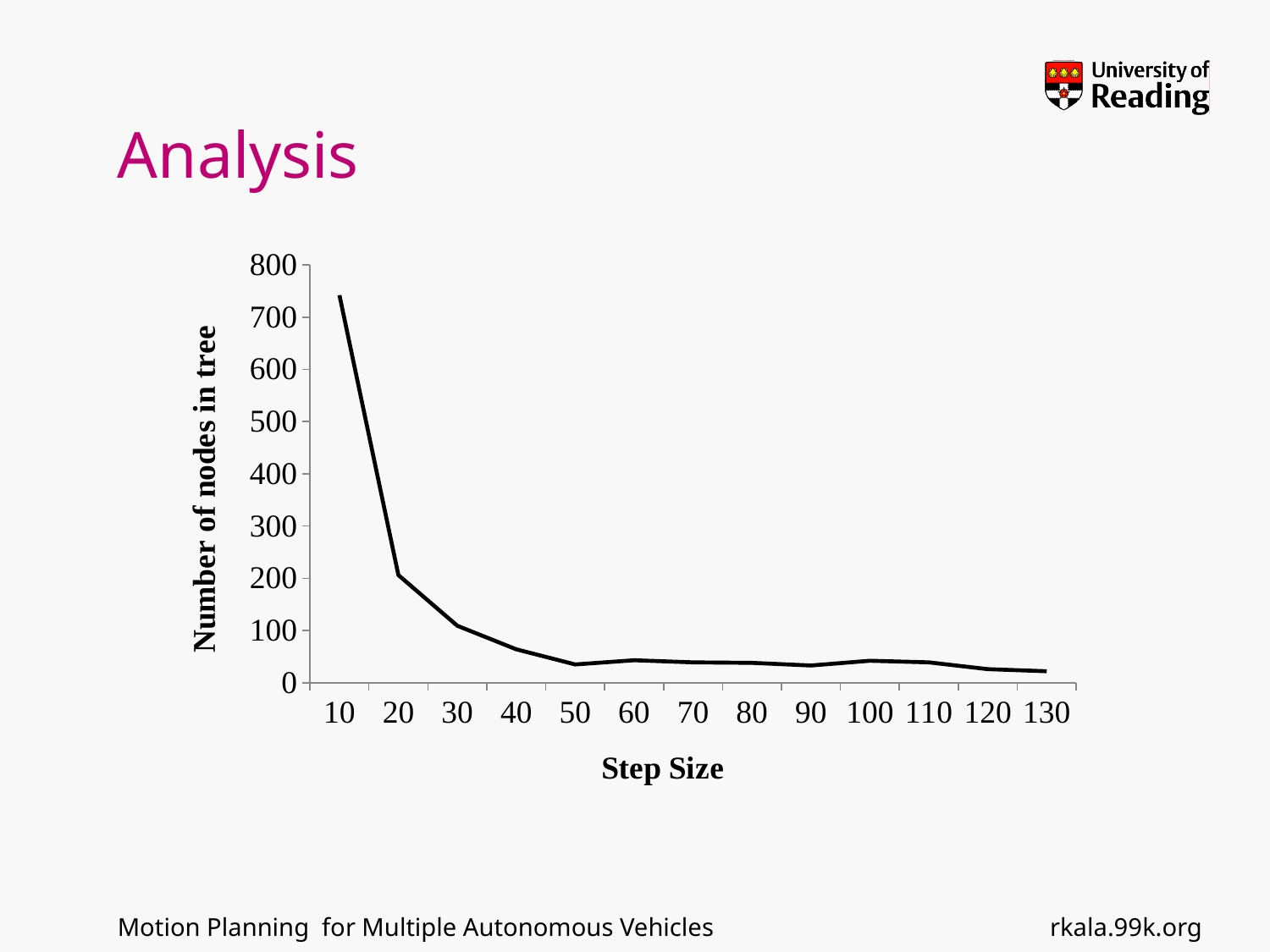
Is the number of nodes in tree at step size 130 greater or less than 100? less Is the number of nodes in tree at step size 10 greater or less than 700? greater What kind of chart is shown on the slide? line chart Is the number of nodes in tree at step size 30 greater or less than 200? less How many step size values are plotted along the x axis? 13 Does the number of nodes in tree generally rise or fall as step size increases? fall Which has more nodes in tree: step size 10 or step size 20? step size 10 Which has more nodes in tree: step size 30 or step size 130? step size 30 At which step size is the number of nodes in tree highest? 10 What is the label of the y axis? Number of nodes in tree